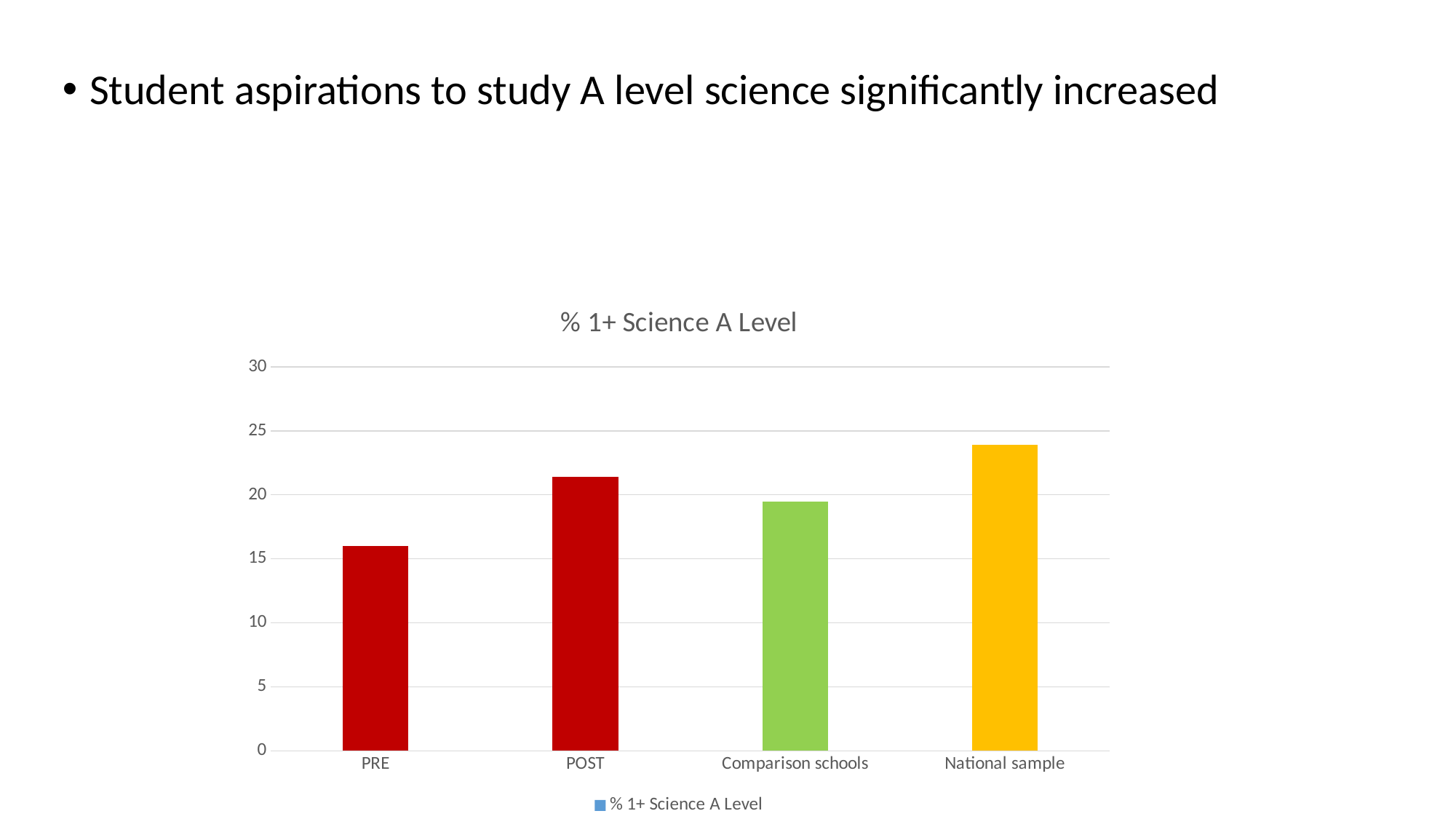
How many series does the chart legend list? 1 Is the value for National sample greater or less than 25? less What is the title of the chart? % 1+ Science A Level Which has the larger value, PRE or POST? POST Which has the larger value, POST or Comparison schools? POST How many categories are shown on the x axis of the chart? 4 What colour is the bar for National sample? Yellow What type of chart is shown on the slide? Bar chart Which category has the highest value in the chart? National sample Which category has the lowest value in the chart? PRE Is the value for POST greater or less than 20? greater Is the value for PRE greater or less than 15? greater